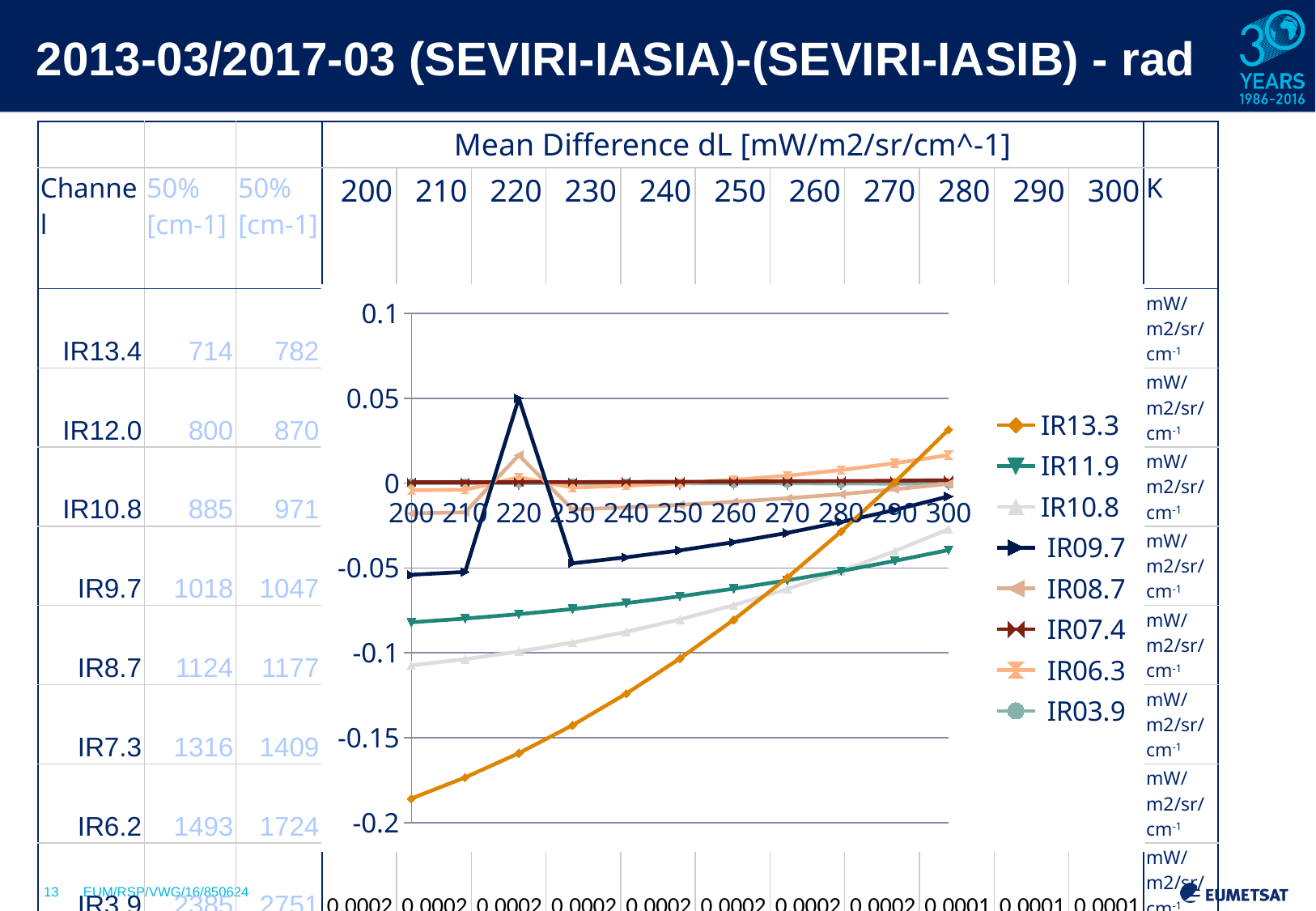
Which series has the highest value at x = 300? IR13.3 How many points are marked along the x axis of the chart (from 200 to 300)? 11 Does the IR13.3 series rise or fall as x increases from 200 to 300? rise Is the value for IR09.7 at x = 200 greater or less than -0.1? greater Is the value for IR13.3 at x = 300 greater or less than 0? greater What kind of chart is shown on the slide? line chart Is the value for IR13.3 at x = 200 greater or less than -0.15? less What is the title shown above the chart? Mean Difference dL [mW/m2/sr/cm^-1] Which series is listed first in the chart legend? IR13.3 Which series has the lowest value at x = 200? IR13.3 How many series does the chart legend list? 8